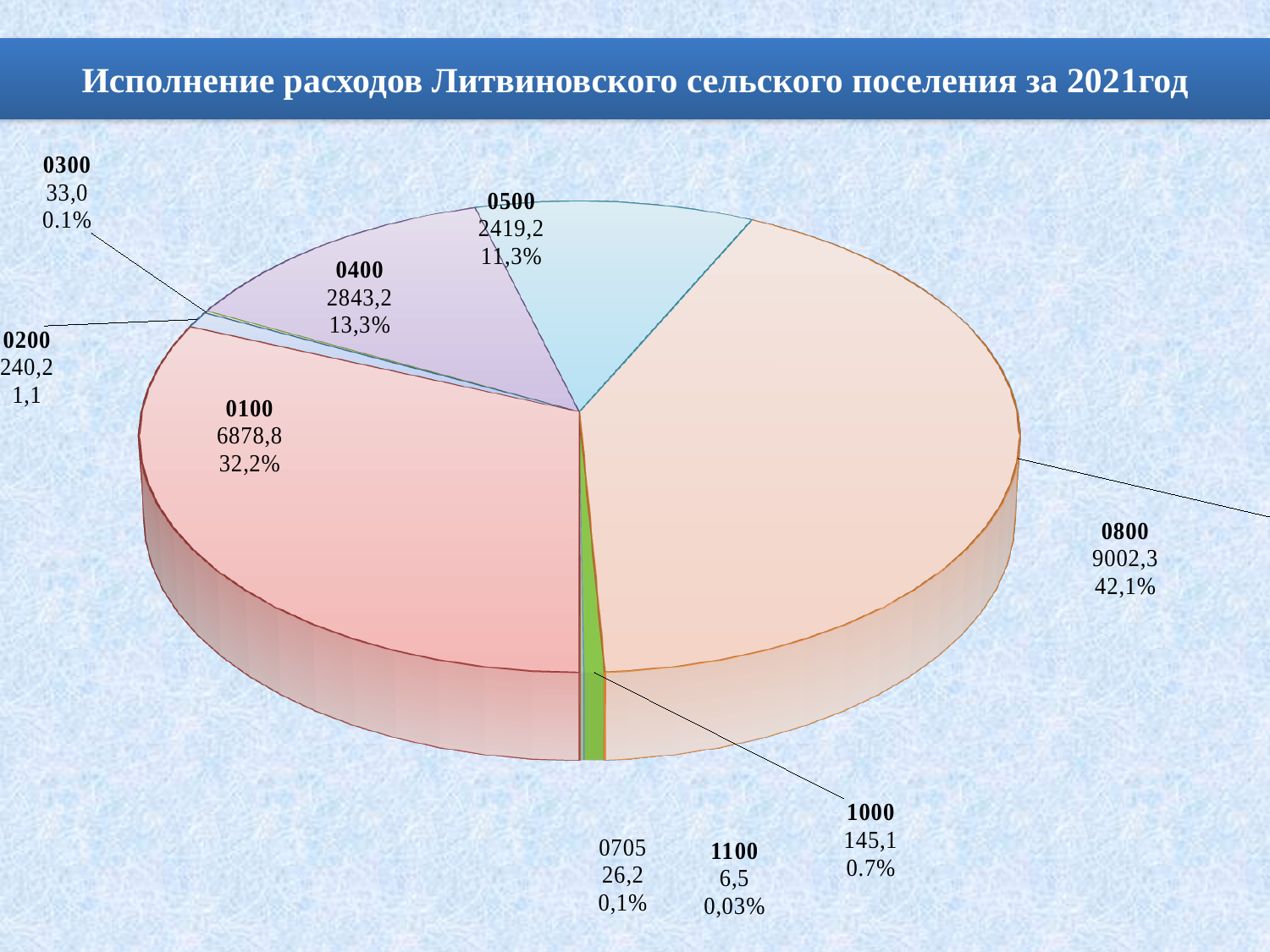
What percentage share is shown for category 0100? 32,2% Which category has the largest share of the pie? 0800 Which category has the smallest value in the pie chart? 1100 What is the value shown for category 1000? 145,1 What is the title of the chart on the slide? Исполнение расходов Литвиновского сельского поселения за 2021год What is the difference between the values for 0800 and 0100? 2123,5 What kind of chart is shown on the slide? pie chart What is the value shown for category 0400? 2843,2 What is the value shown for category 0800? 9002,3 What percentage share is shown for category 0500? 11,3% How many categories are labelled in the pie chart? 9 Which is larger, the value for 0400 or the value for 0500? 0400